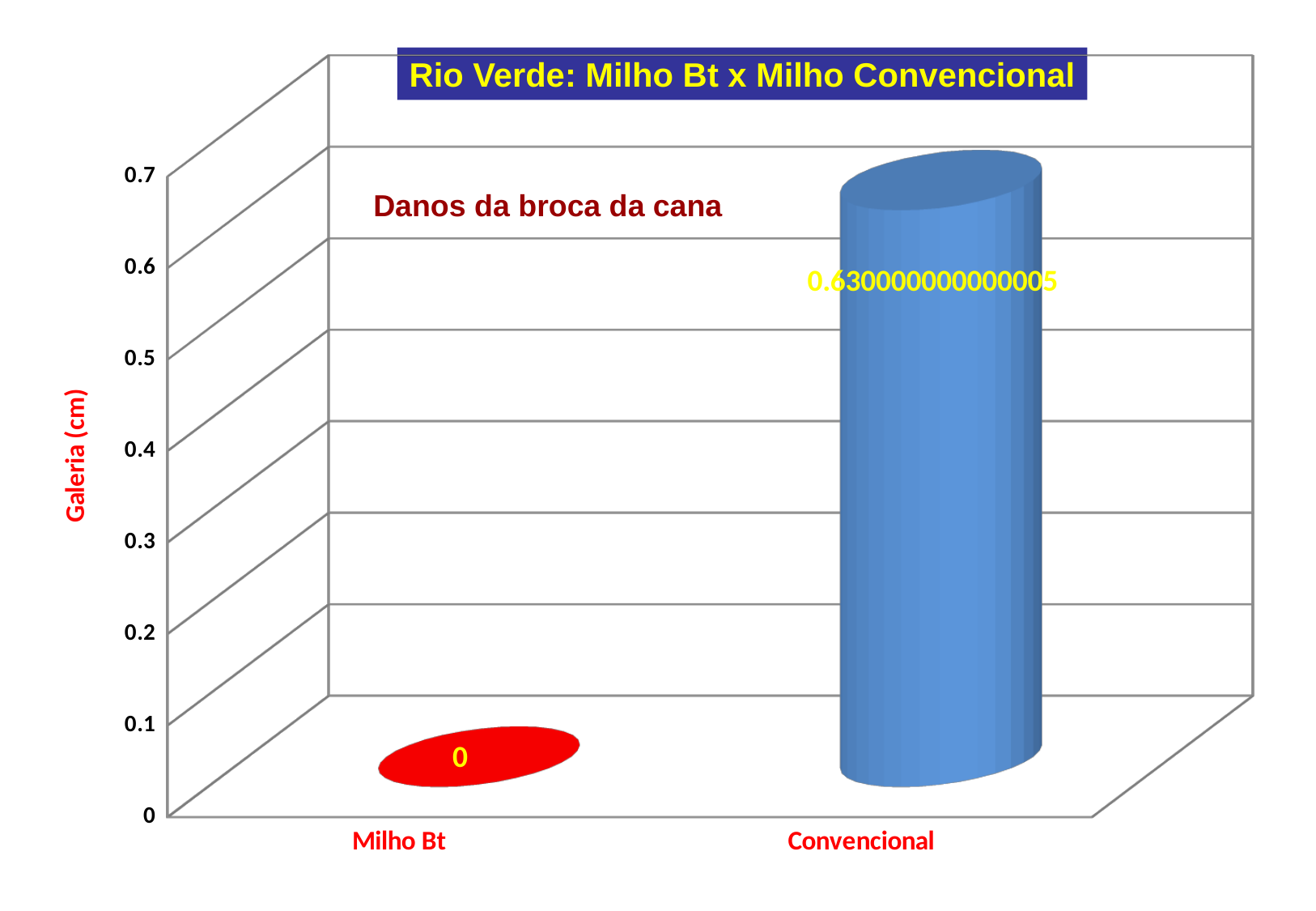
Is the value for Convencional greater or less than 0.5? greater What kind of chart is shown on the slide? bar chart Which category has the lowest value? Milho Bt Which is larger, the value for Milho Bt or the value for Convencional? Convencional How many categories are shown on the x axis? 2 Which category has the highest value? Convencional What is the difference between the values for Convencional and Milho Bt? 0.630000000000005 What is the value for Milho Bt? 0 What is the value for Convencional? 0.630000000000005 Is the value for Milho Bt greater or less than 0.1? less What is the label of the vertical axis? Galeria (cm) What is the title of the chart? Rio Verde: Milho Bt x Milho Convencional